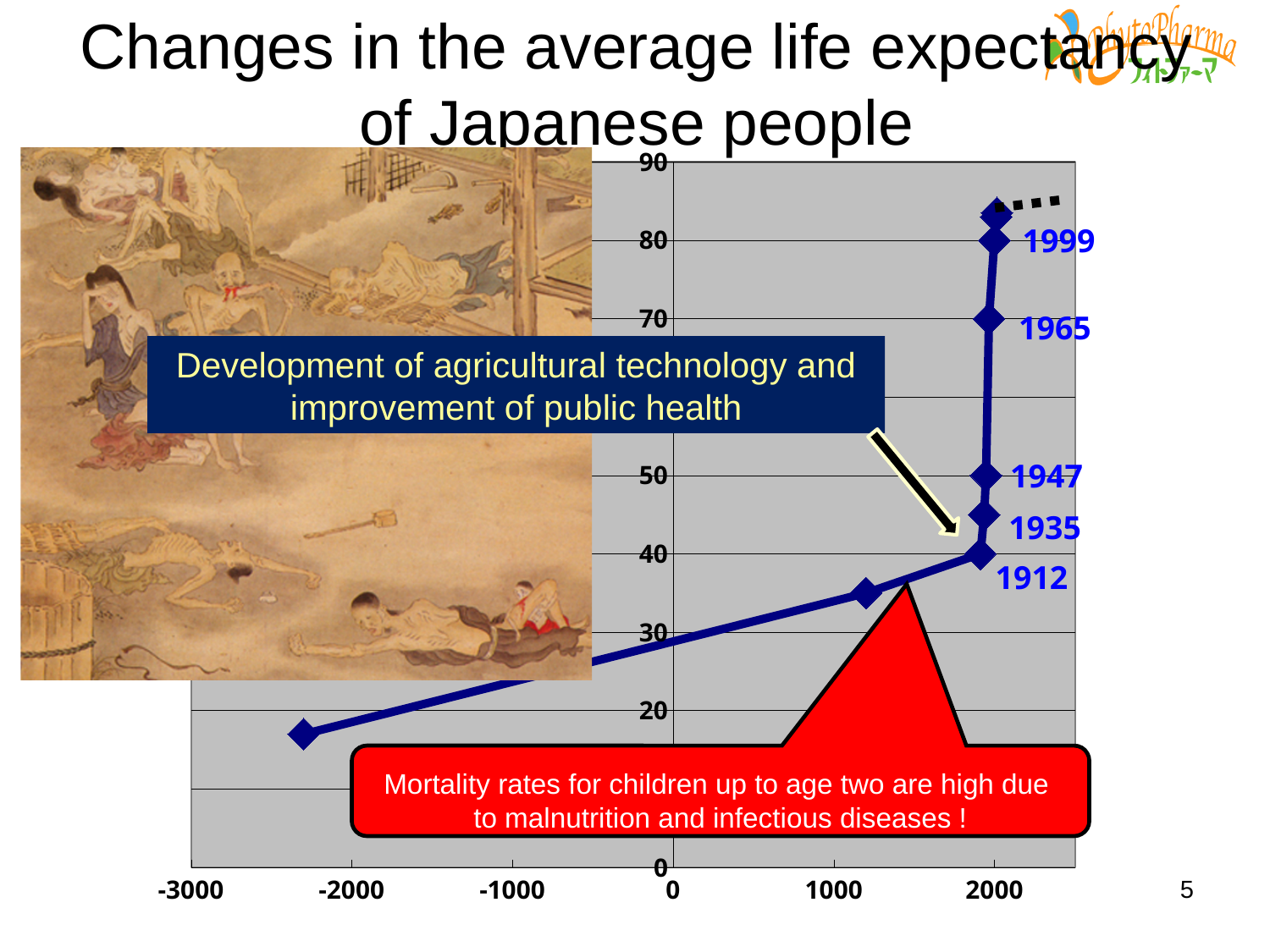
Do the plotted life expectancy values rise or fall as the years increase along the x axis? rise Which has the larger life expectancy value, 1999 or 1912? 1999 What kind of chart is shown on the slide? line chart Which labeled year has the lowest life expectancy value? 1912 How many data points on the chart are labeled with a year? 5 What is the lowest year shown on the x axis? -3000 Is the value of the leftmost data point (around year -2300) greater or less than 20? less Is the life expectancy value for 1935 greater or less than 40? greater What life expectancy value does the 1965 point land on? 70 Is the life expectancy value for 1935 greater or less than 50? less Which labeled year has the highest life expectancy value? 1999 What is the title of the chart on the slide? Changes in the average life expectancy of Japanese people